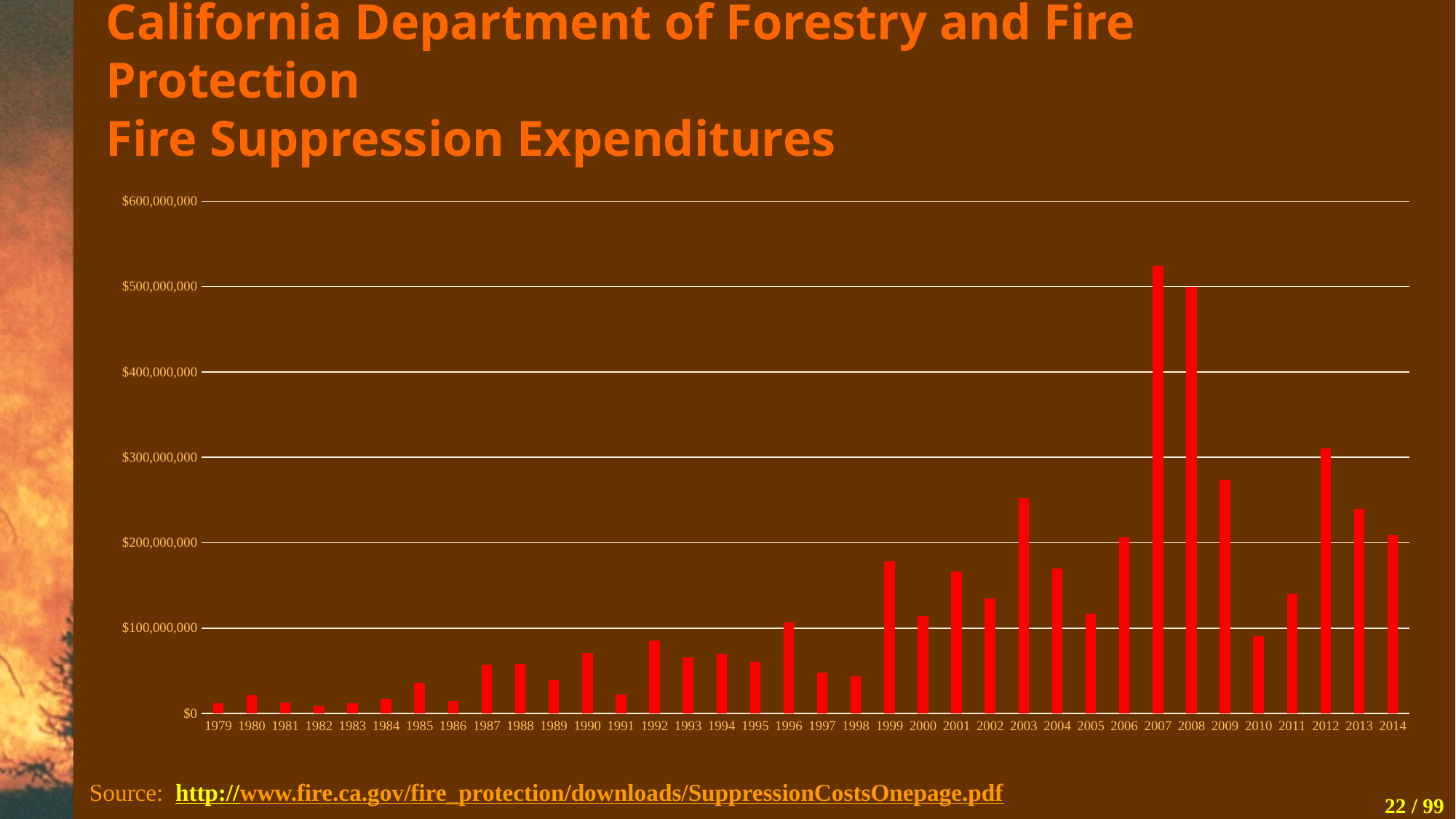
Which year has the larger expenditure, 2003 or 2004? 2003 Is the value for 2007 greater or less than $500,000,000? greater Is the value for 2003 greater or less than $200,000,000? greater How many years are plotted on the x axis? 36 What kind of chart is shown on the slide? Bar chart Is the value for 2010 greater or less than $100,000,000? less Which year has the larger expenditure, 2007 or 2008? 2007 Overall, do fire suppression expenditures rise or fall from 1979 to 2014? Rise What colour are the bars in the chart? Red Which year has the highest fire suppression expenditure? 2007